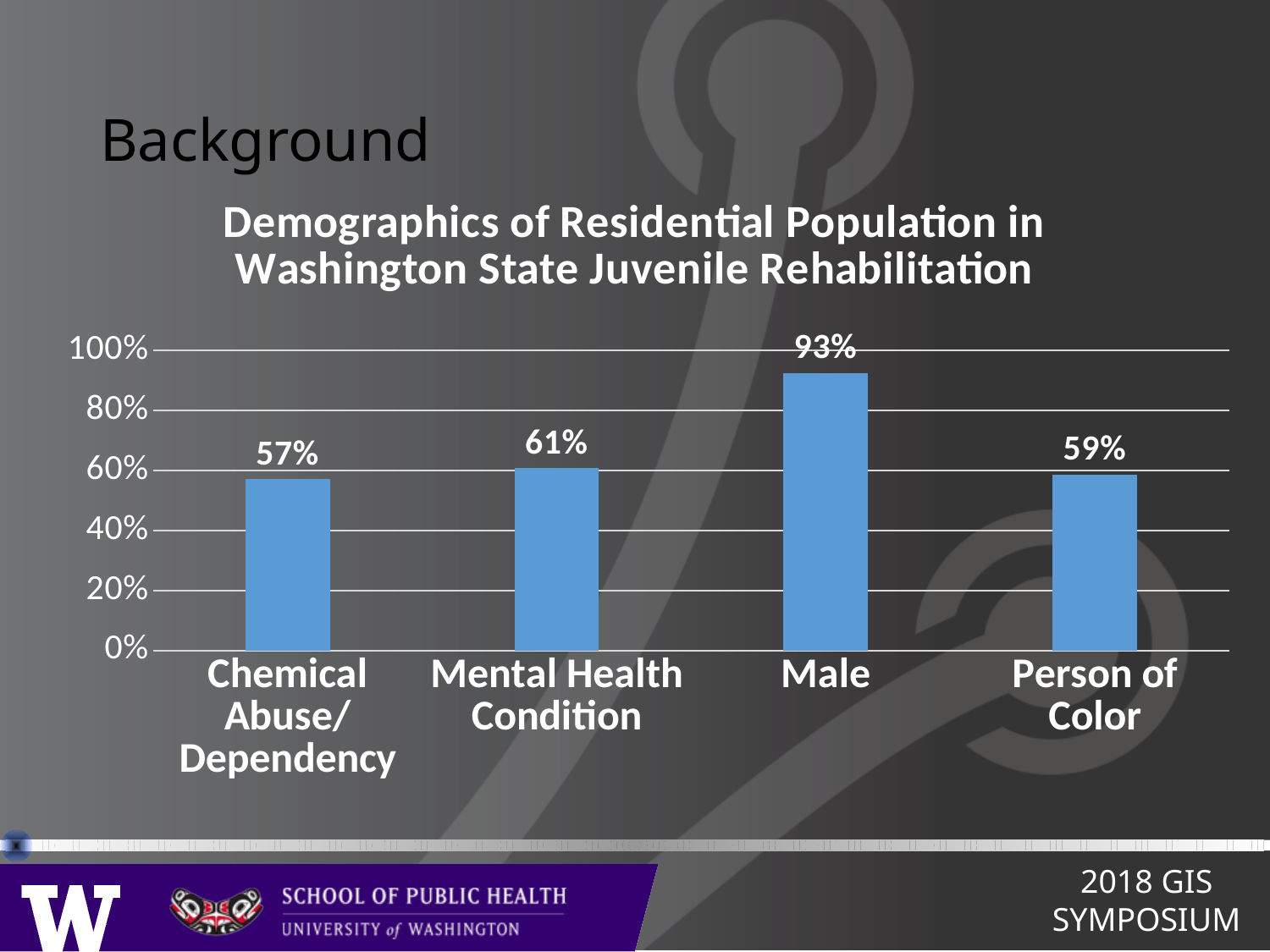
What is the value for Mental Health Condition? 61% What is the difference between the values for Male and Chemical Abuse/Dependency? 36% What is the value for Male? 93% What is the value for Chemical Abuse/Dependency? 57% Which category has the highest value? Male What kind of chart is shown on the slide? Bar chart Which category has the lowest value? Chemical Abuse/Dependency What is the value for Person of Color? 59% What is the title of the chart? Demographics of Residential Population in Washington State Juvenile Rehabilitation How many categories are shown in the chart? 4 What is the difference between the values for Mental Health Condition and Person of Color? 2% Which is larger, the value for Mental Health Condition or the value for Person of Color? Mental Health Condition